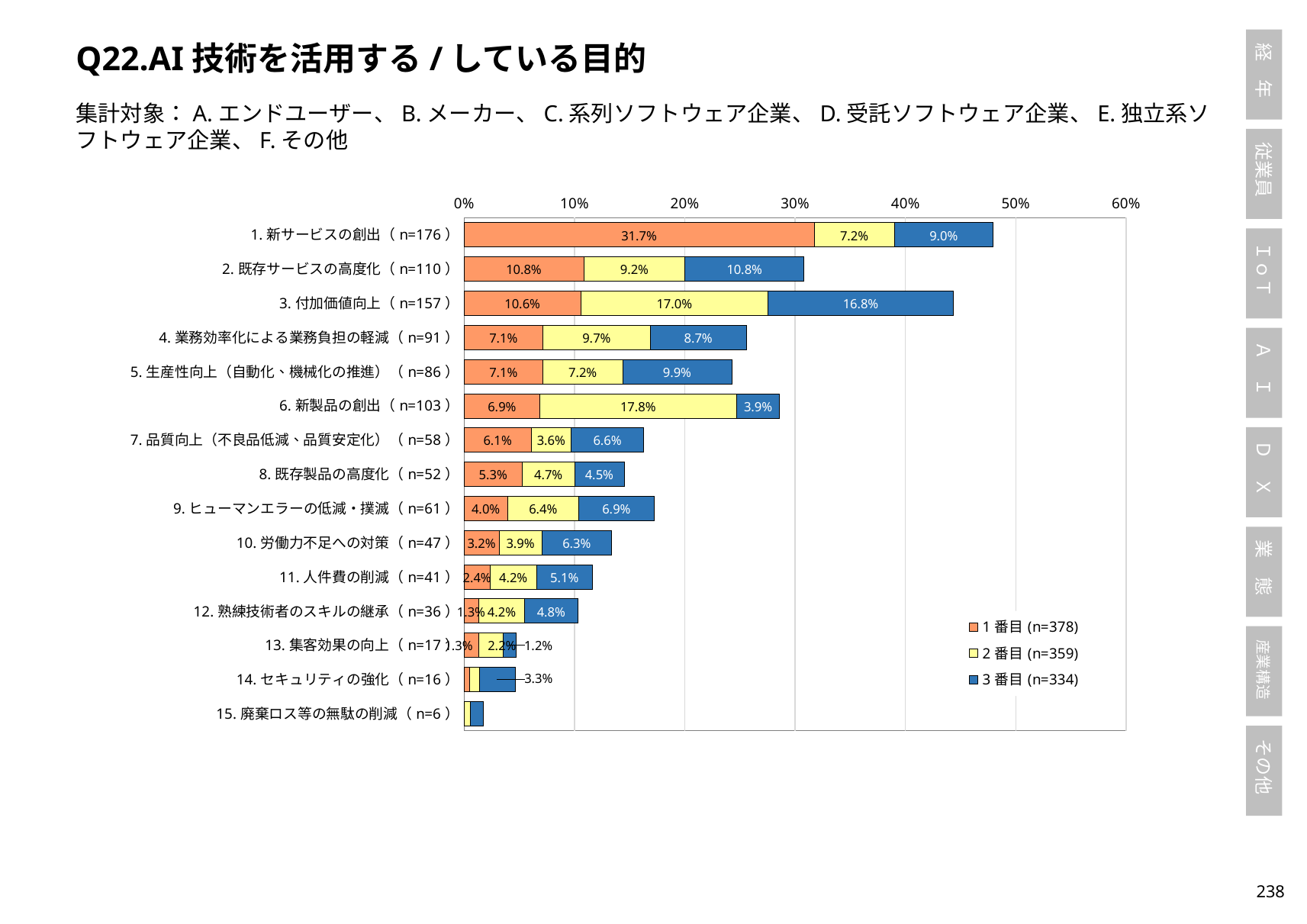
What is the value of the 3 番目 series for 3. 付加価値向上 (n=157)? 16.8% How many categories are shown on the chart? 15 What is the value of the 2 番目 series for 6. 新製品の創出 (n=103)? 17.8% How many series does the legend list? 3 What is the total of the stacked bar for 2. 既存サービスの高度化 (n=110)? 30.8% Which is larger: the 3 番目 value for 5. 生産性向上 (n=86) or the 3 番目 value for 4. 業務効率化による業務負担の軽減 (n=91)? 5. 生産性向上 (n=86) Is the total of the stacked bar for 1. 新サービスの創出 (n=176) greater or less than 40%? greater Which category has the highest 1 番目 value? 1. 新サービスの創出 (n=176) What is the value of the 1 番目 series for 1. 新サービスの創出 (n=176)? 31.7% What kind of chart is shown on the slide? Stacked horizontal bar chart What is the difference between the 2 番目 values for 3. 付加価値向上 (n=157) and 2. 既存サービスの高度化 (n=110)? 7.8% What is the total of the stacked bar for 4. 業務効率化による業務負担の軽減 (n=91)? 25.5%